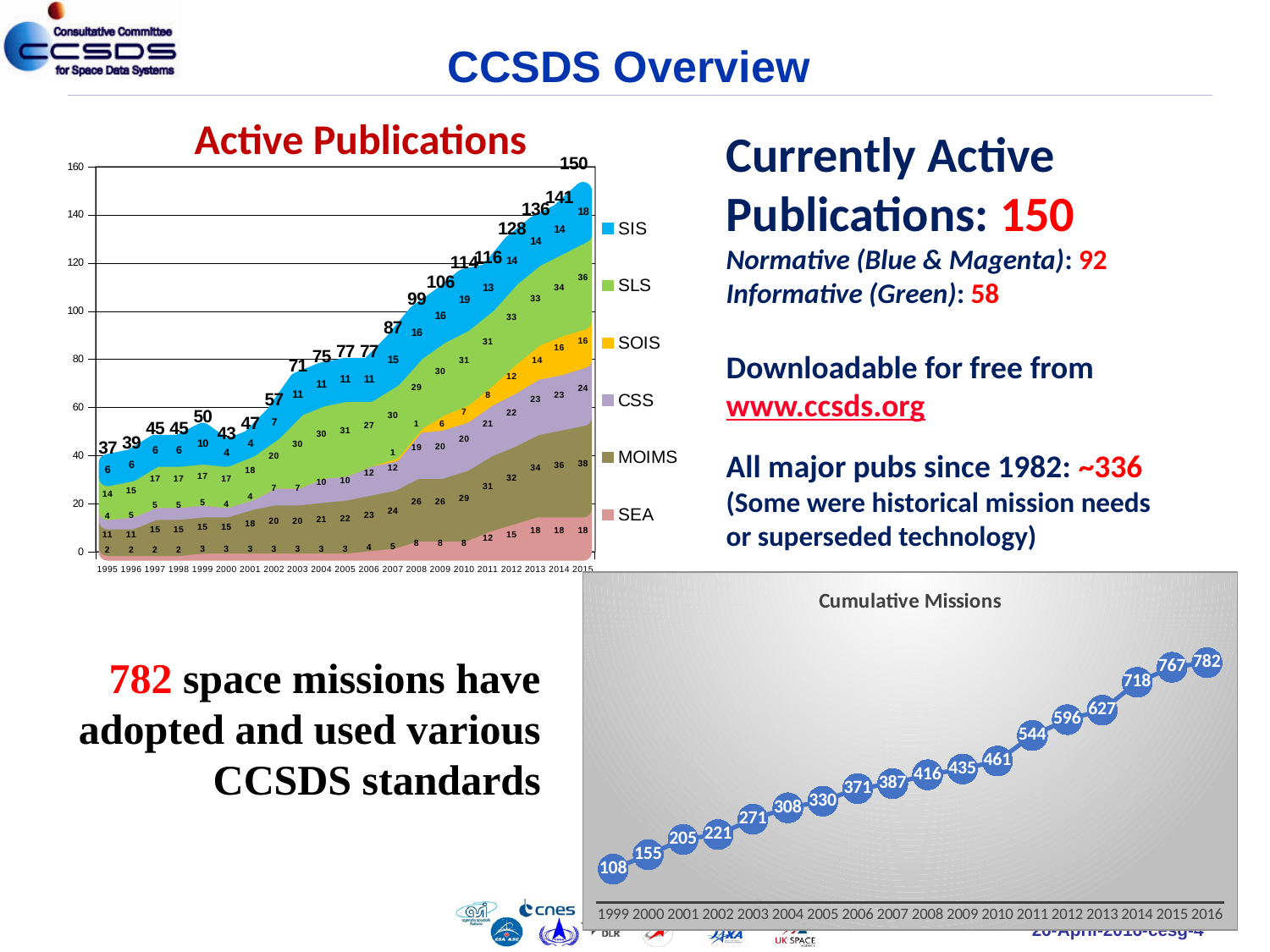
In the Active Publications chart, what is the total number of active publications in 1995? 37 In the Active Publications chart, which year has the lowest total of active publications? 1995 What kind of chart is the Active Publications chart? stacked area chart How many data points are plotted in the Cumulative Missions chart? 18 In the Cumulative Missions chart, do the values rise or fall from 1999 to 2016? rise In the Cumulative Missions chart, what is the value for 1999? 108 How many series does the legend of the Active Publications chart list? 6 In the Cumulative Missions chart, which is larger, the value for 2011 or the value for 2010? 2011 In the Cumulative Missions chart, what is the difference between the 2016 and 2015 values? 15 In the Active Publications chart, what is the difference between the 2015 total and the 2014 total? 9 In the Cumulative Missions chart, what is the value for 2016? 782 In the Active Publications chart, what is the total number of active publications in 2015? 150